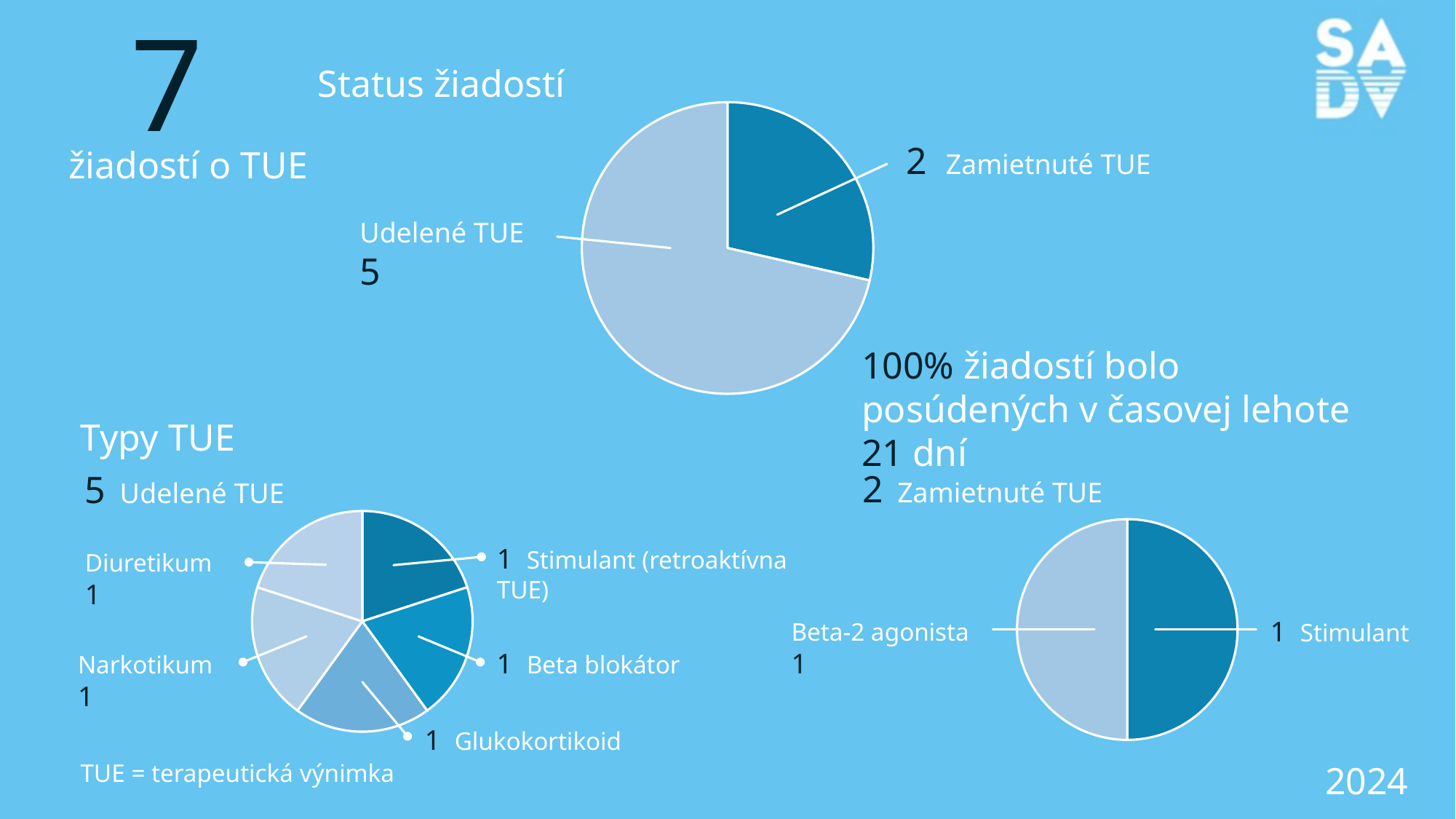
In the 'Status žiadostí' pie chart, what is the difference between Udelené TUE and Zamietnuté TUE? 3 What kind of chart is used for 'Status žiadostí'? Pie chart In the bottom-right pie chart (Zamietnuté TUE types), what share of the pie does Stimulant represent? 50% In the 'Status žiadostí' pie chart, how many slices are there? 2 In the 'Status žiadostí' pie chart, what is the value for Udelené TUE? 5 In the 'Status žiadostí' pie chart, what is the value for Zamietnuté TUE? 2 In the bottom-left pie chart (Udelené TUE types), how many categories are shown? 5 In the bottom-left pie chart (Udelené TUE types), what is the value for Glukokortikoid? 1 In the bottom-right pie chart (Zamietnuté TUE types), how many slices are there? 2 In the bottom-right pie chart (Zamietnuté TUE types), what is the value for Beta-2 agonista? 1 In the 'Status žiadostí' pie chart, which category is the largest? Udelené TUE In the bottom-left pie chart (Udelené TUE types), what is the value for Beta blokátor? 1